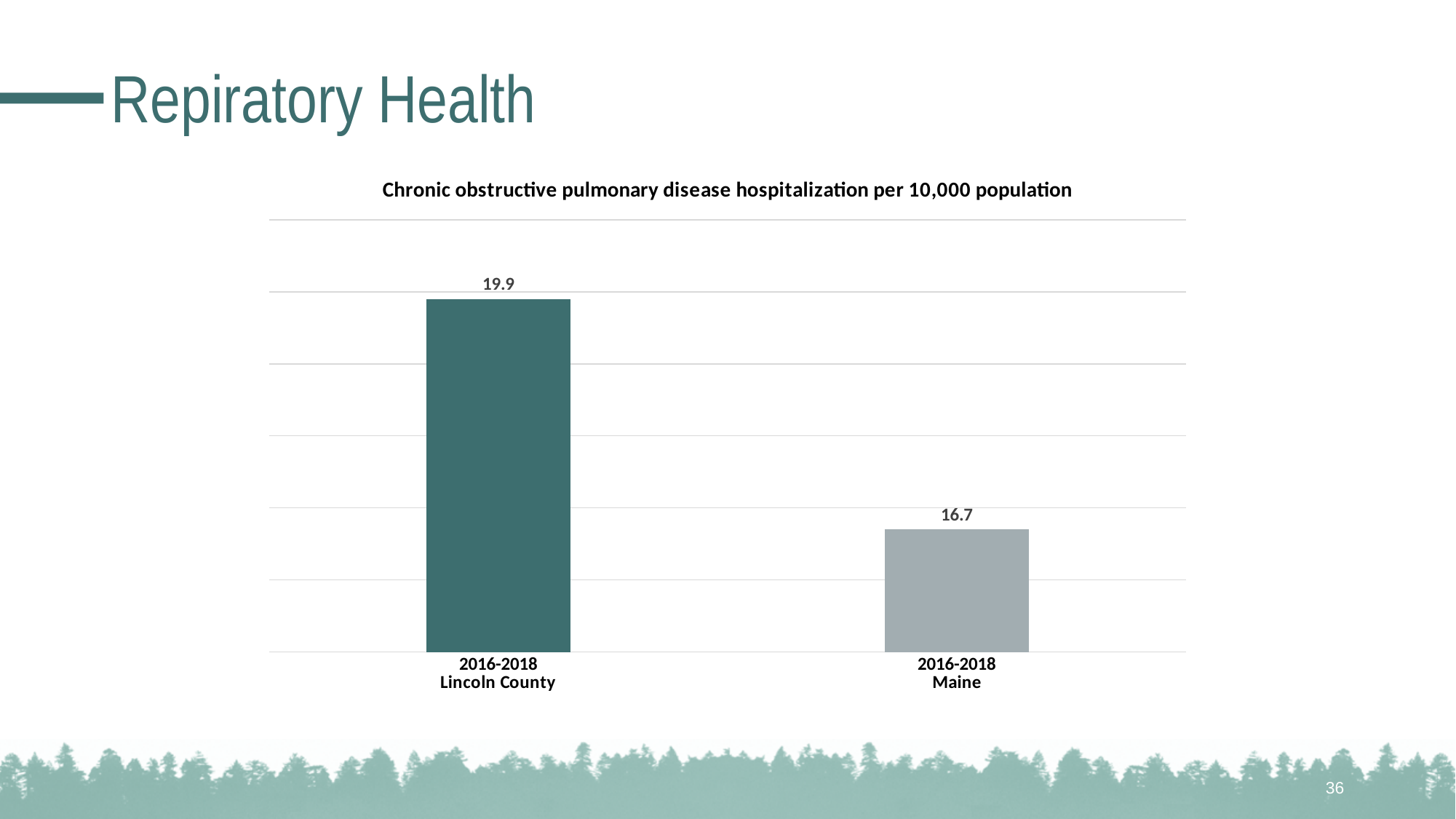
What is the difference between the Lincoln County and Maine COPD hospitalization rates? 3.2 How many bars are shown in the chart? 2 Which category has the lower COPD hospitalization rate? Maine What is the title of the chart? Chronic obstructive pulmonary disease hospitalization per 10,000 population What time period do both bars in the chart cover? 2016-2018 Which category has the higher COPD hospitalization rate, Lincoln County or Maine? Lincoln County Is the COPD hospitalization rate for Maine larger or smaller than that for Lincoln County? smaller What is the COPD hospitalization rate per 10,000 population for Lincoln County (2016-2018)? 19.9 What type of chart is shown on the slide? bar chart What is the COPD hospitalization rate per 10,000 population for Maine (2016-2018)? 16.7